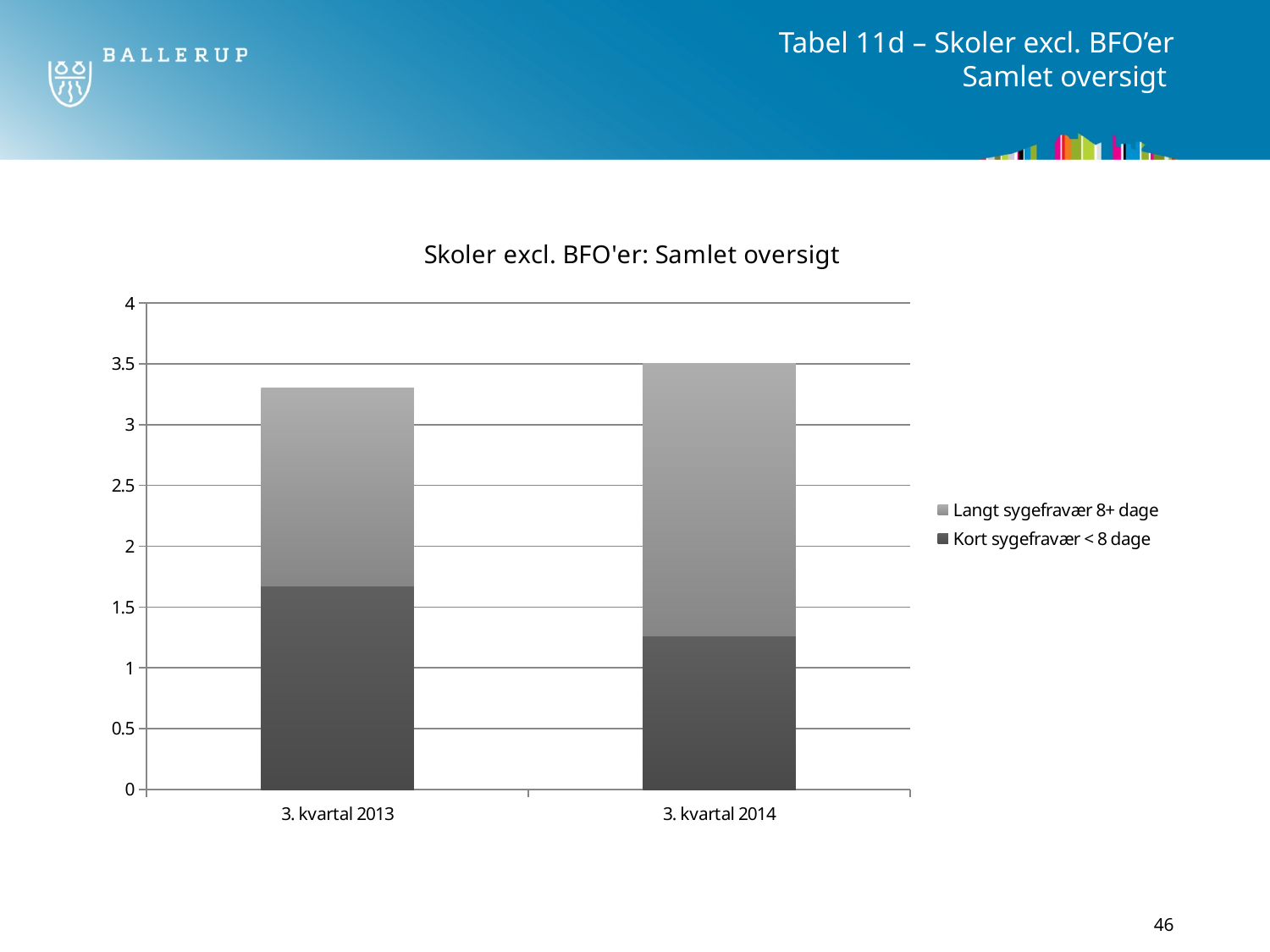
Is the value for Kort sygefravær < 8 dage in 3. kvartal 2013 greater or less than 1.5? greater How many categories are shown on the x axis of the chart? 2 Which quarter has the taller stacked bar overall, 3. kvartal 2013 or 3. kvartal 2014? 3. kvartal 2014 Does the value for Kort sygefravær < 8 dage rise or fall from 3. kvartal 2013 to 3. kvartal 2014? fall What is the title of the chart? Skoler excl. BFO'er: Samlet oversigt Is the value for Kort sygefravær < 8 dage in 3. kvartal 2014 greater or less than 1.5? less Which quarter has the larger value for Kort sygefravær < 8 dage, 3. kvartal 2013 or 3. kvartal 2014? 3. kvartal 2013 How many series does the chart's legend list? 2 Which series is shown in the darker grey at the bottom of each bar? Kort sygefravær < 8 dage Is the Langt sygefravær 8+ dage segment for 3. kvartal 2014 greater or less than 2? greater What kind of chart is shown on the slide? Stacked bar chart